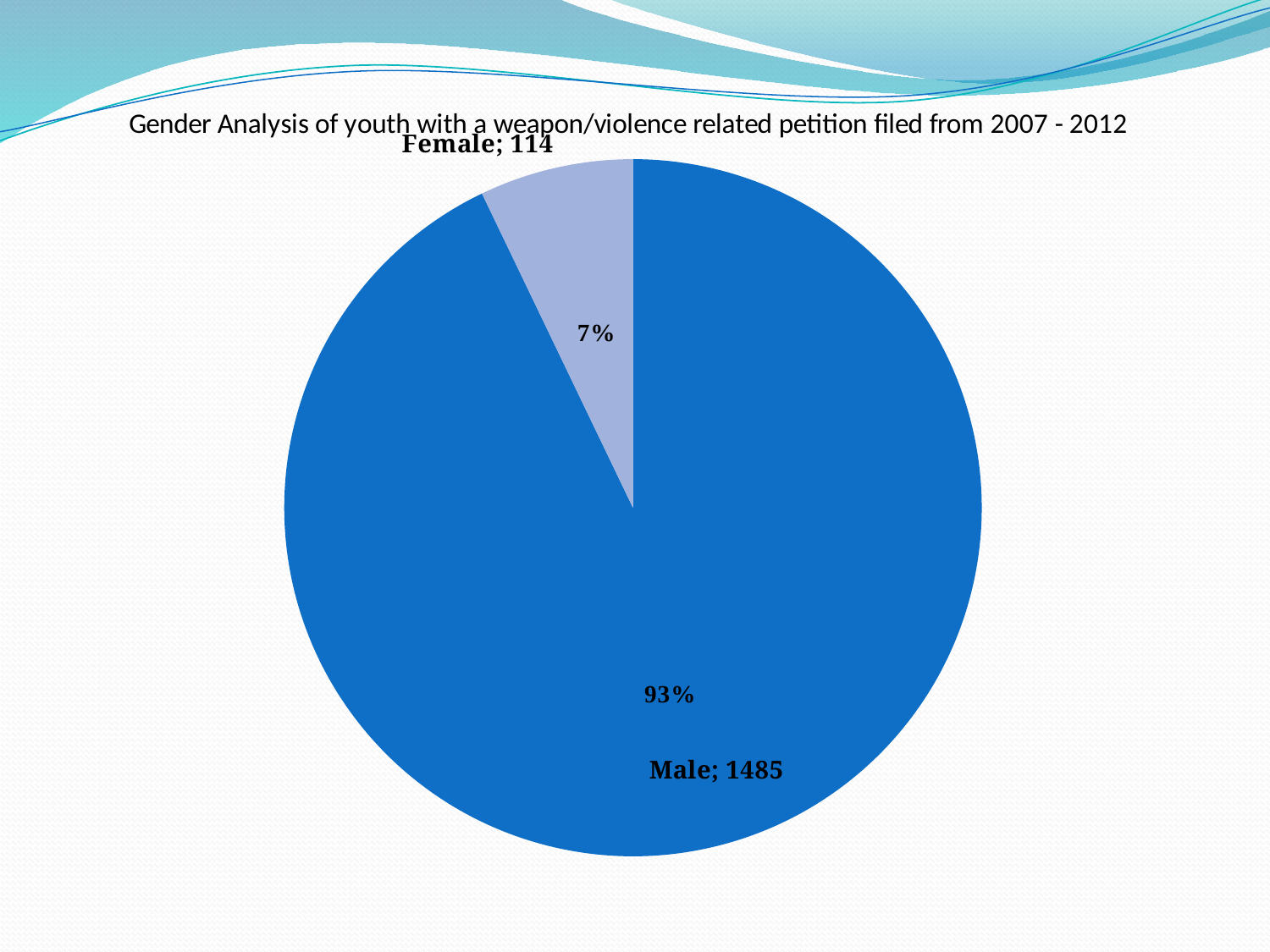
What is the value for Male? 1485 Which category has the smallest slice? Female What is the total of the Male and Female values? 1599 What is the difference between the Male and Female values? 1371 What kind of chart is shown on the slide? pie chart What is the value for Female? 114 Which is larger, the value for Male or the value for Female? Male How many slices does the pie chart have? 2 Which category has the largest slice? Male What percentage share of the pie does the Female slice represent? 7% What is the title of the chart? Gender Analysis of youth with a weapon/violence related petition filed from 2007 - 2012 What percentage share of the pie does the Male slice represent? 93%